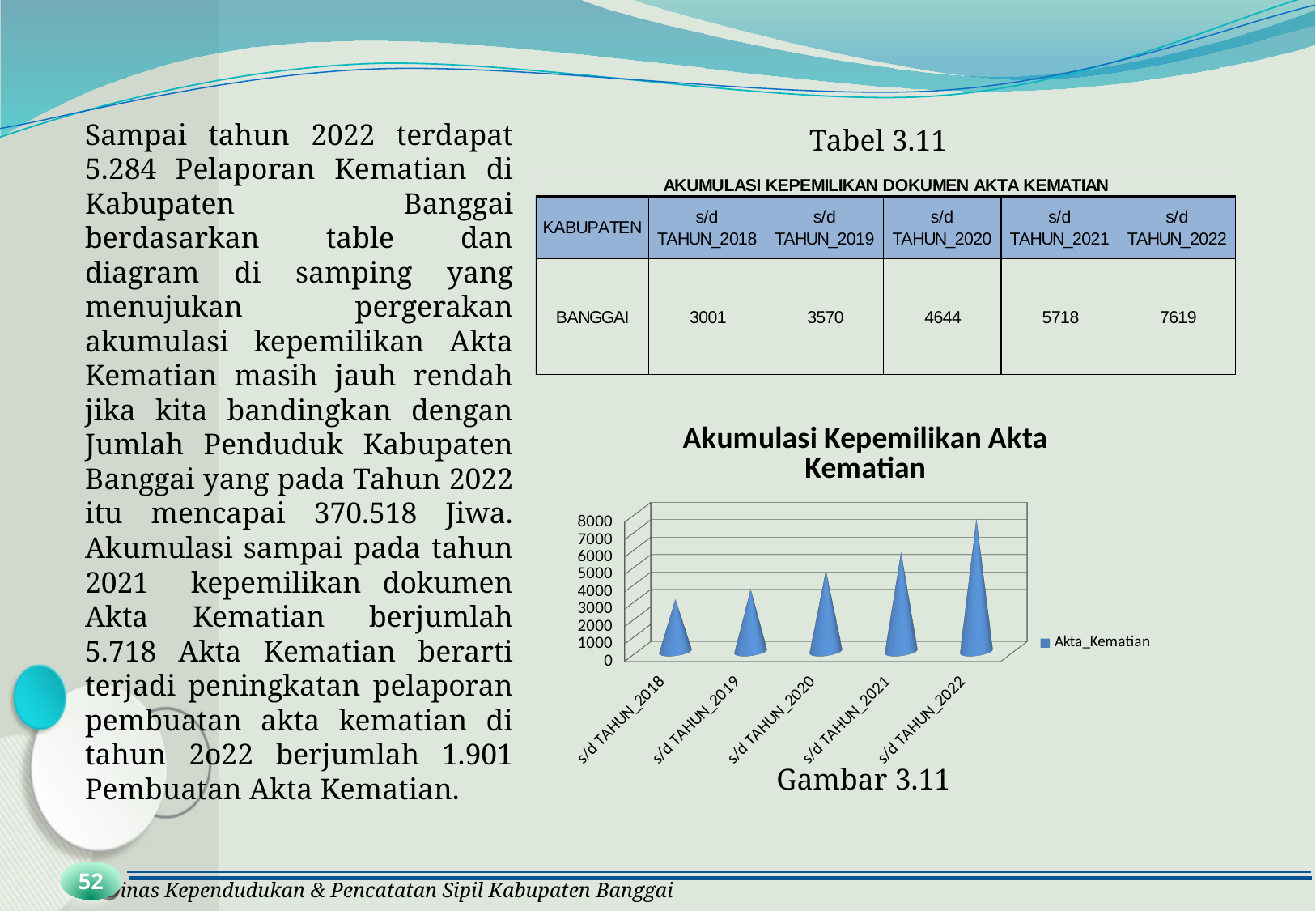
Is the value for s/d TAHUN_2022 in the chart greater or less than 7000? greater According to the table Tabel 3.11, what is the value for BANGGAI s/d TAHUN_2022? 7619 Is the value for s/d TAHUN_2018 in the chart greater or less than 4000? less Which category has the highest value in the 'Akumulasi Kepemilikan Akta Kematian' chart? s/d TAHUN_2022 Do the values in the 'Akumulasi Kepemilikan Akta Kematian' chart rise or fall from s/d TAHUN_2018 to s/d TAHUN_2022? rise What is the name of the series shown in the legend of the chart? Akta_Kematian Which is larger in the chart, the value for s/d TAHUN_2020 or the value for s/d TAHUN_2021? s/d TAHUN_2021 How many series does the legend of the 'Akumulasi Kepemilikan Akta Kematian' chart list? 1 Which category has the lowest value in the 'Akumulasi Kepemilikan Akta Kematian' chart? s/d TAHUN_2018 What type of chart is shown under the title 'Akumulasi Kepemilikan Akta Kematian'? bar chart Using the values in Tabel 3.11, what is the difference between s/d TAHUN_2022 and s/d TAHUN_2021 for BANGGAI? 1901 How many categories are plotted along the x axis of the 'Akumulasi Kepemilikan Akta Kematian' chart? 5